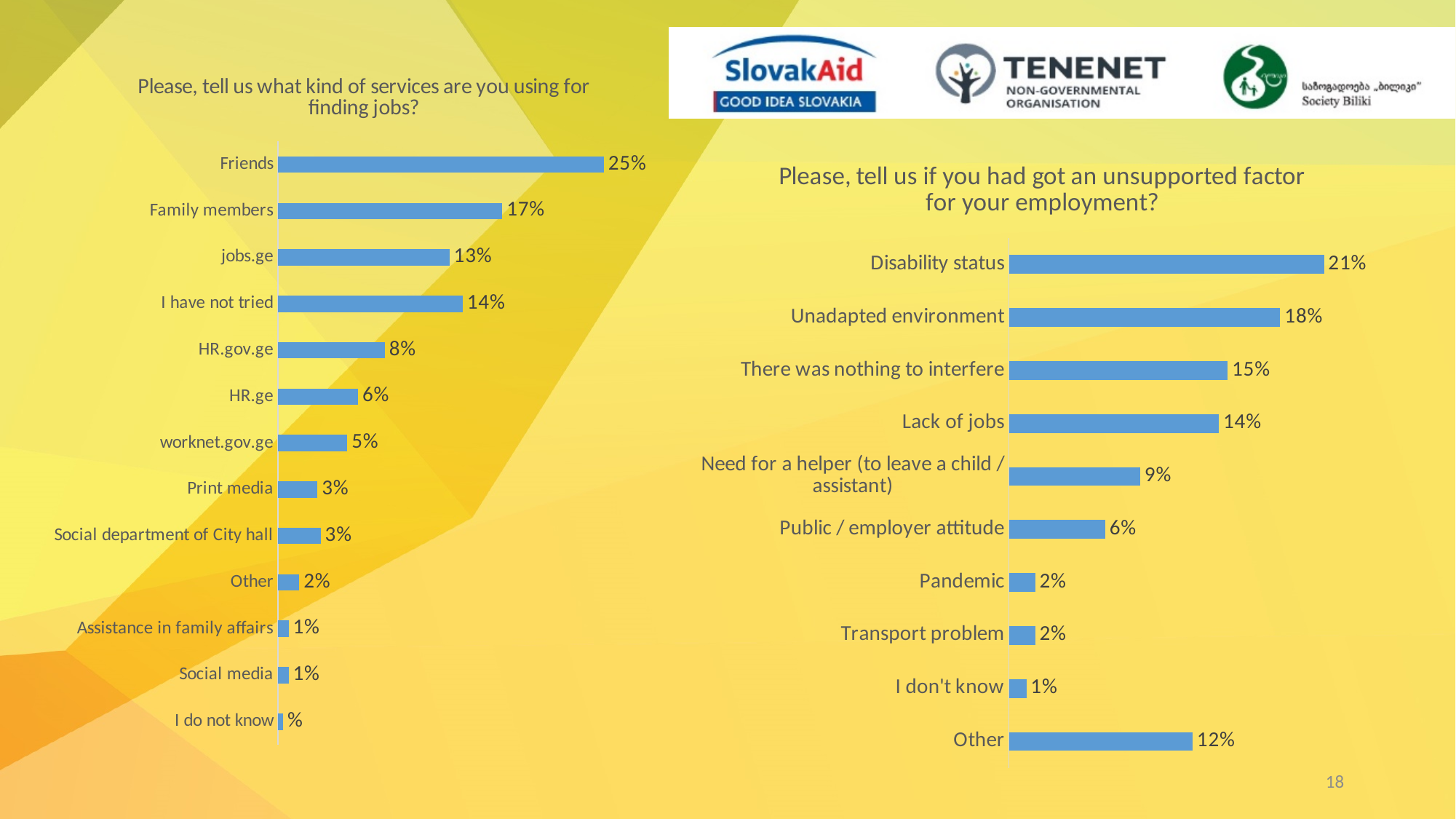
In the chart titled "Please, tell us what kind of services are you using for finding jobs?", what is the value for HR.gov.ge? 8% In the chart titled "Please, tell us if you had got an unsupported factor for your employment?", how many categories are shown? 10 In the chart titled "Please, tell us if you had got an unsupported factor for your employment?", what is the value for Other? 12% In the chart titled "Please, tell us if you had got an unsupported factor for your employment?", what is the value for Disability status? 21% What type of chart is the one on the right side of the slide? Bar chart In the chart titled "Please, tell us what kind of services are you using for finding jobs?", what is the difference between Family members and jobs.ge? 4% In the chart titled "Please, tell us if you had got an unsupported factor for your employment?", which category has the lowest value? I don't know In the chart titled "Please, tell us what kind of services are you using for finding jobs?", which is larger: I have not tried or jobs.ge? I have not tried In the chart titled "Please, tell us if you had got an unsupported factor for your employment?", what is the difference between Unadapted environment and Lack of jobs? 4% In the chart titled "Please, tell us what kind of services are you using for finding jobs?", which category has the highest value? Friends In the chart titled "Please, tell us what kind of services are you using for finding jobs?", how many categories are shown? 13 In the chart titled "Please, tell us what kind of services are you using for finding jobs?", what is the value for Friends? 25%